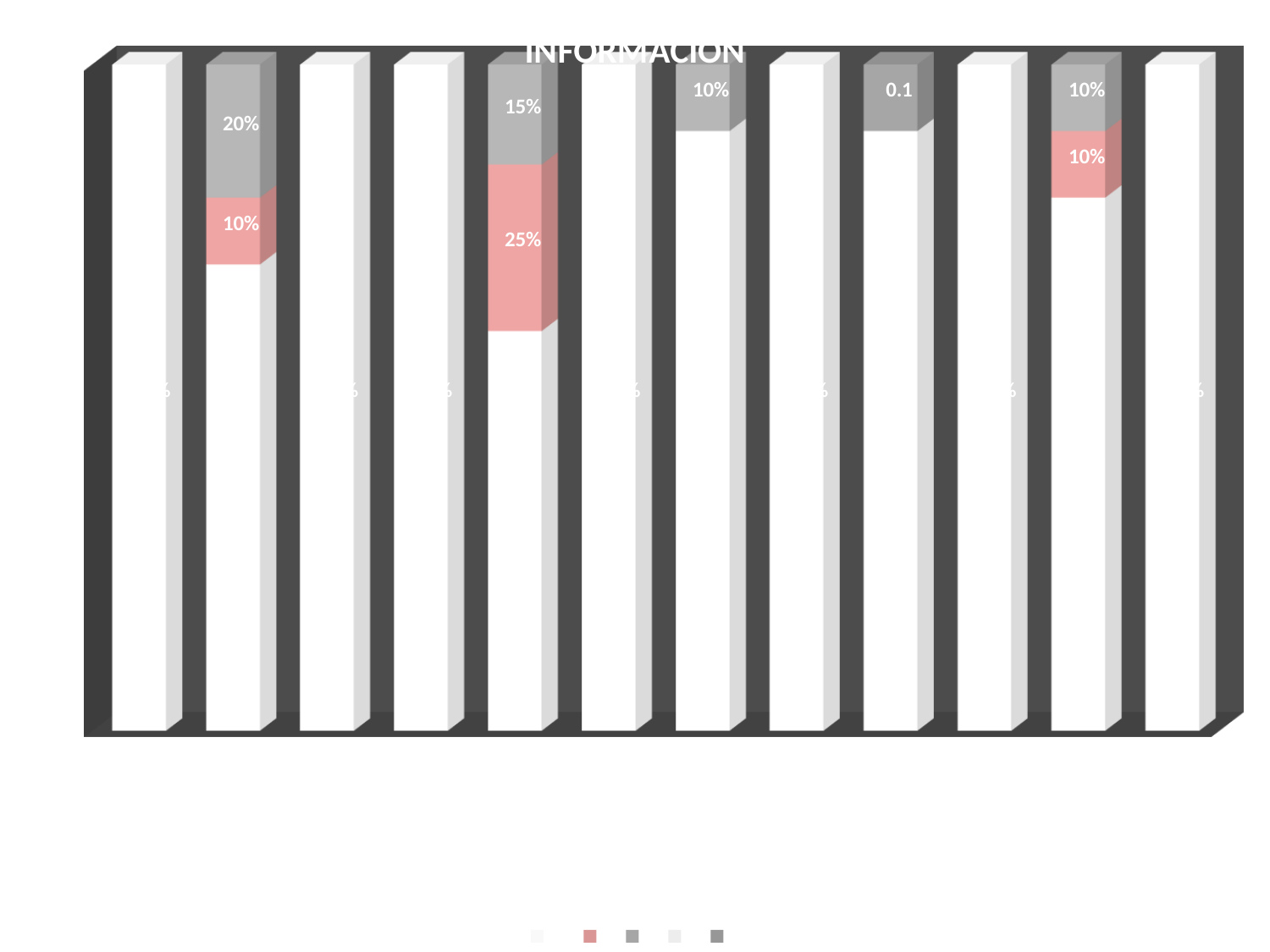
What is the title of the chart? INFORMACION What is the value of the pink segment in the second bar from the left? 10% Which bar has the largest pink segment? The fifth bar from the left How many series does the legend list? 5 What is the value of the pink segment in the fifth bar from the left? 25% What is the difference between the pink segment of the fifth bar from the left and the pink segment of the second bar from the left? 15% How many bars are plotted in the chart? 12 What is the value of the gray segment in the second bar from the left? 20% What is the value of the gray segment in the fifth bar from the left? 15% Which has the larger gray segment: the second bar from the left or the fifth bar from the left? The second bar from the left What kind of chart is shown on the slide? Stacked bar chart What label is printed on the gray segment of the ninth bar from the left? 0.1